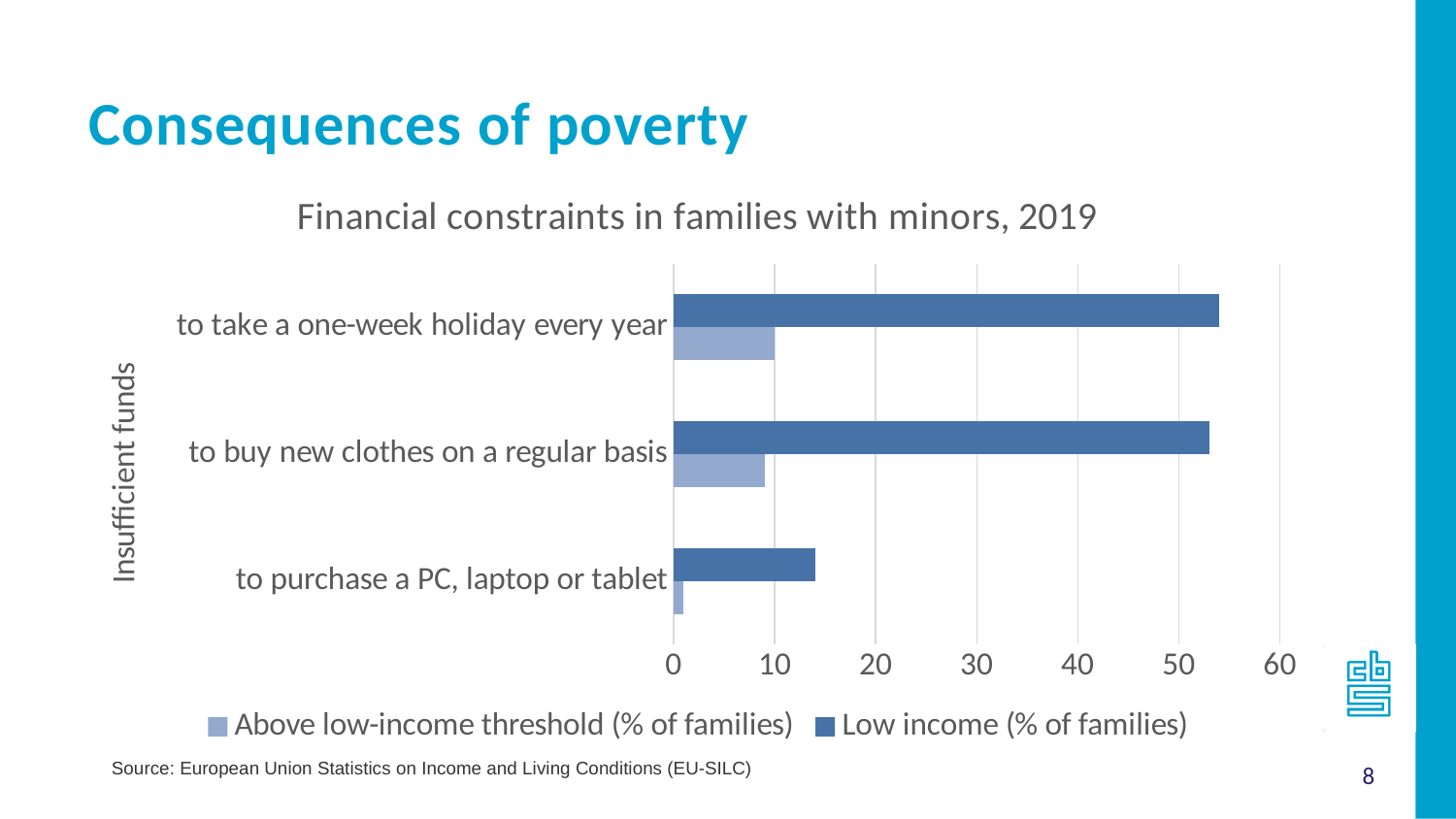
How many categories are shown on the chart? 3 How many series does the legend list? 2 What is the label of the vertical axis? Insufficient funds What kind of chart is shown on the slide? bar chart Which category has the lowest value for Low income (% of families)? to purchase a PC, laptop or tablet Is the Above low-income threshold value for 'to purchase a PC, laptop or tablet' greater or less than 10? less What is the title of the chart? Financial constraints in families with minors, 2019 Is the Low income value for 'to purchase a PC, laptop or tablet' greater or less than 10? greater Is the Low income value for 'to take a one-week holiday every year' greater or less than 50? greater Which category has the lowest value for Above low-income threshold (% of families)? to purchase a PC, laptop or tablet For 'to take a one-week holiday every year', which series has the larger value: Low income or Above low-income threshold? Low income